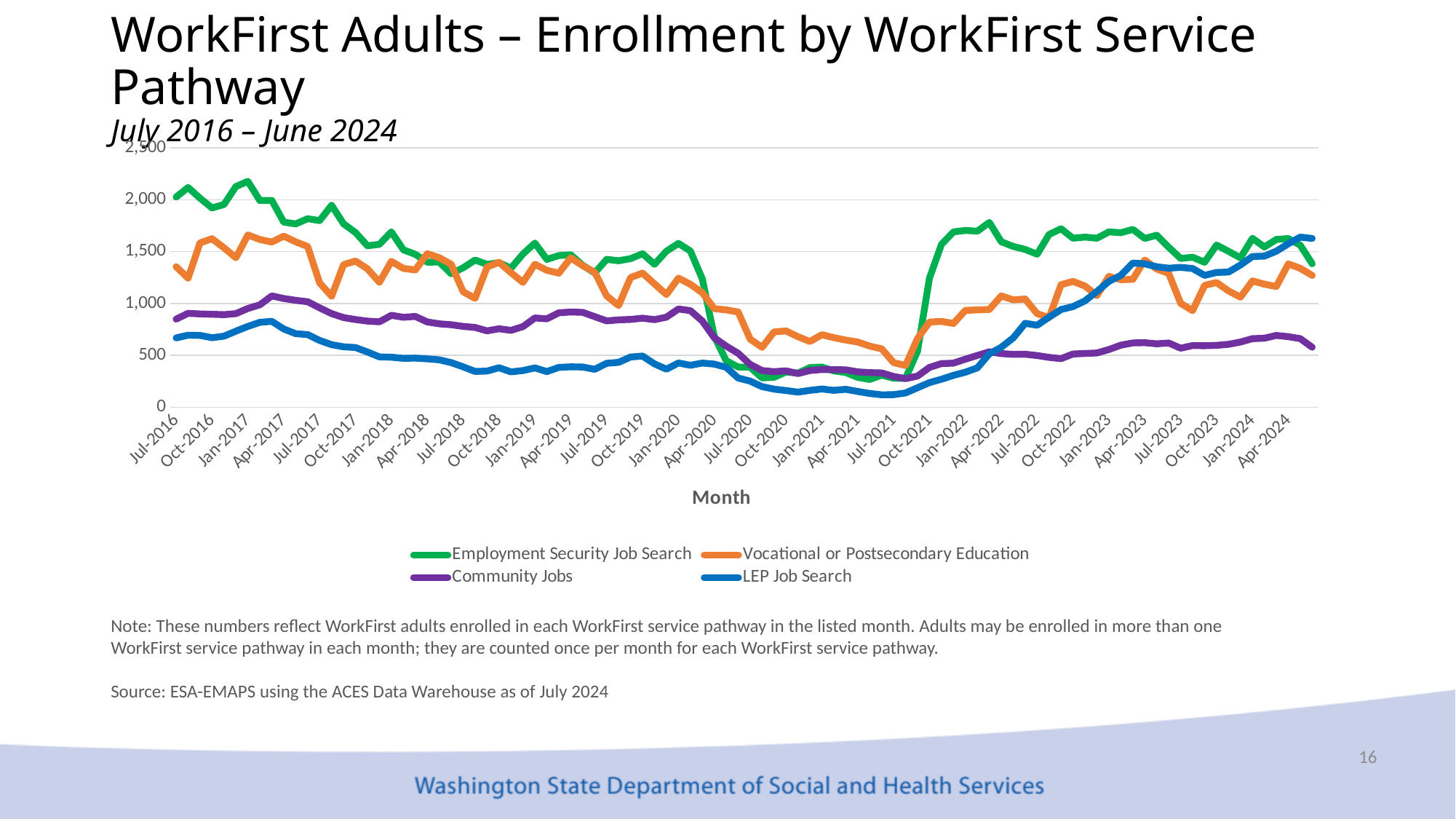
At Jan-2022, which is larger: Employment Security Job Search or Vocational or Postsecondary Education? Employment Security Job Search Is the value for Vocational or Postsecondary Education at Jul-2016 greater or less than 1,000? greater Which series has the highest value at Jul-2016? Employment Security Job Search Is the value for LEP Job Search at Jan-2021 greater or less than 500? less Does the LEP Job Search line rise or fall from Jul-2021 to Apr-2024? rise What kind of chart is shown on the slide? Line chart At Apr-2024, which is larger: LEP Job Search or Community Jobs? LEP Job Search Is the value for Employment Security Job Search at Oct-2020 greater or less than 500? less What is the title of the x axis? Month Which series is drawn in purple? Community Jobs How many series does the legend list? 4 Which series has the lowest value at Jan-2021? LEP Job Search